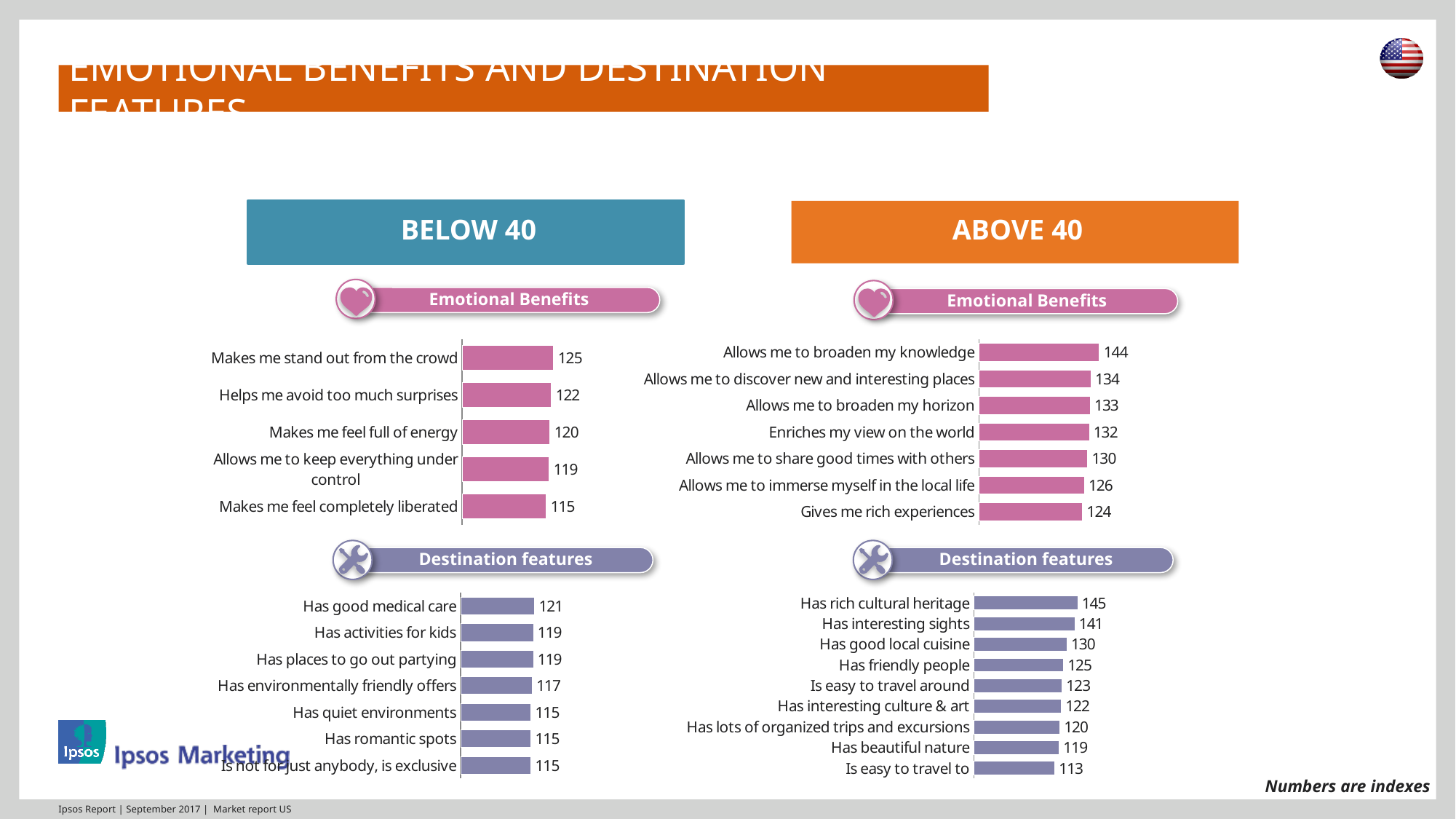
How many categories are shown in the Above 40 Emotional Benefits chart? 7 In the Below 40 Emotional Benefits chart, what is the value for "Makes me feel completely liberated"? 115 In the Above 40 Emotional Benefits chart, what is the difference between "Allows me to broaden my knowledge" and "Gives me rich experiences"? 20 In the Below 40 Destination features chart, what is the value for "Has good medical care"? 121 How many categories are shown in the Above 40 Destination features chart? 9 In the Above 40 Destination features chart, which category has the lowest value? Is easy to travel to In the Above 40 Destination features chart, which is larger: "Has rich cultural heritage" or "Has good local cuisine"? Has rich cultural heritage In the Below 40 Emotional Benefits chart, what is the value for "Makes me stand out from the crowd"? 125 In the Above 40 Emotional Benefits chart, which category has the highest value? Allows me to broaden my knowledge What type of chart is the Below 40 Emotional Benefits chart? Bar chart In the Above 40 Destination features chart, what is the value for "Has interesting sights"? 141 In the Below 40 Destination features chart, what is the difference between "Has good medical care" and "Has quiet environments"? 6